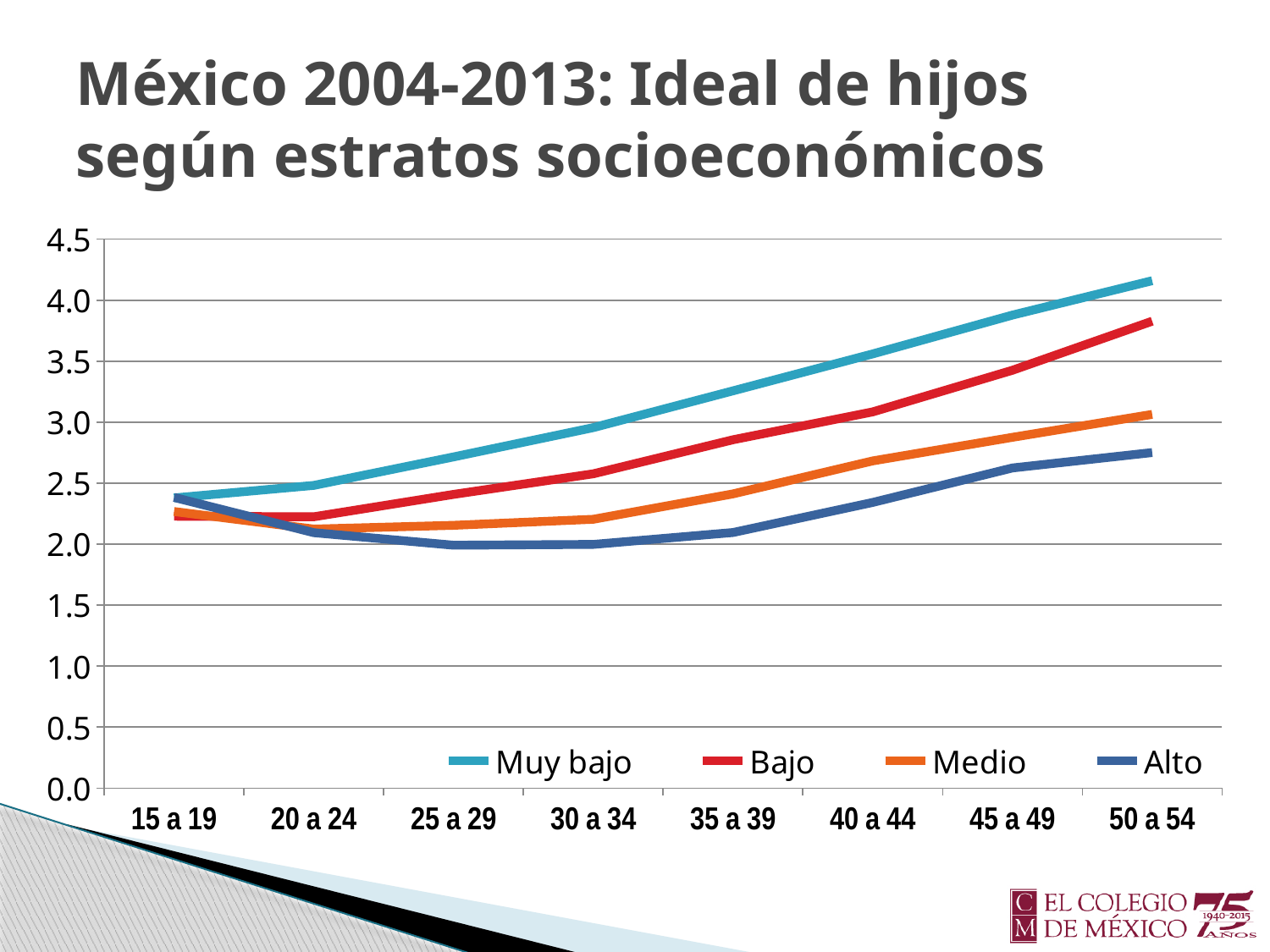
Is the value for Alto at 25 a 29 greater or less than 2.5? less What is the title of the chart on the slide? México 2004-2013: Ideal de hijos según estratos socioeconómicos At 35 a 39, which is larger, the value for Bajo or the value for Medio? Bajo What kind of chart is shown on the slide? line chart Is the value for Bajo at 50 a 54 greater or less than 3.5? greater Is the value for Medio at 50 a 54 greater or less than 2.5? greater Does the Muy bajo line rise or fall from 15 a 19 to 50 a 54? rises How many age groups are shown on the x axis? 8 Which series has the highest value at 50 a 54? Muy bajo How many series does the legend list? 4 Which series has the lowest value at 50 a 54? Alto